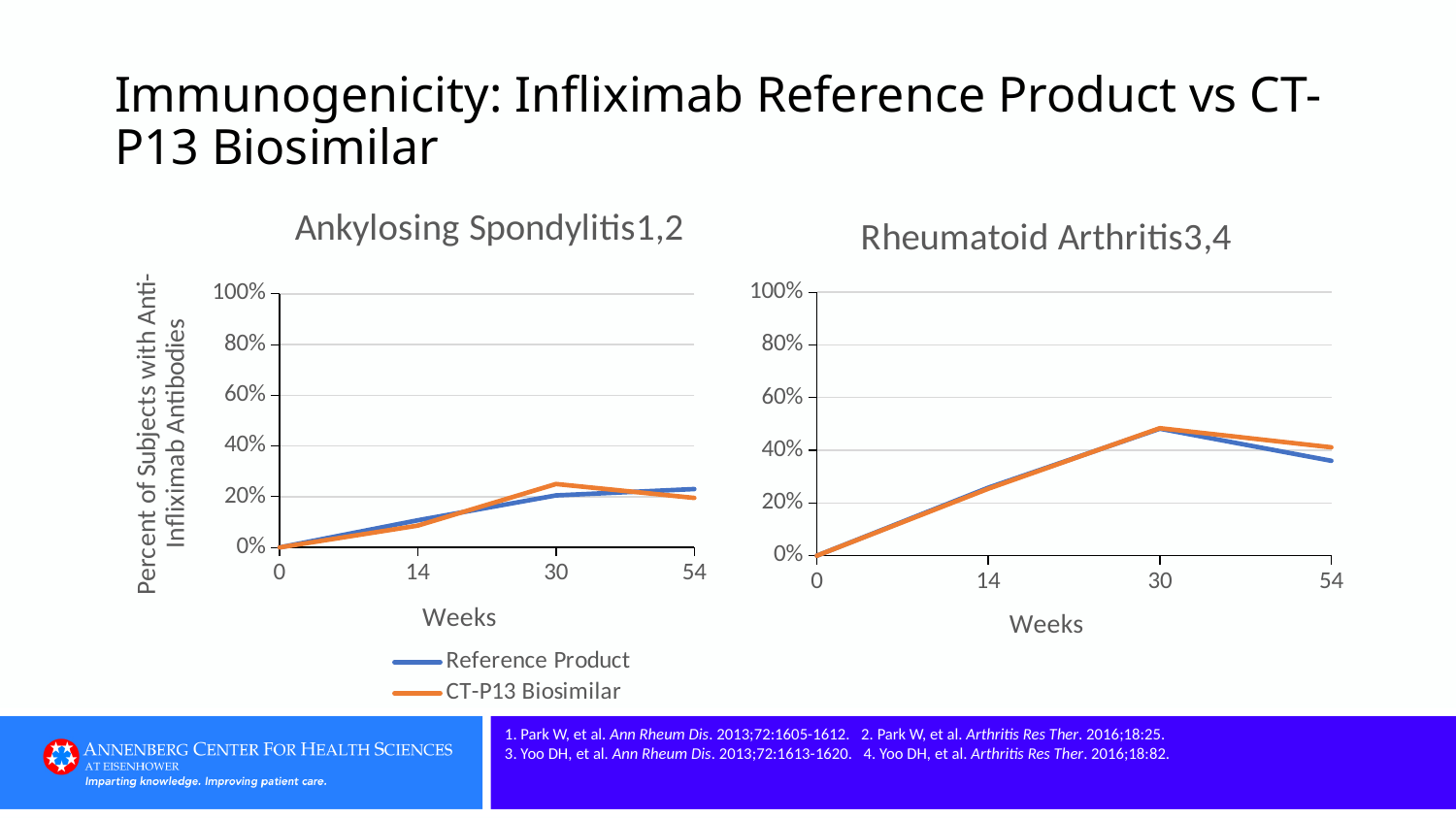
In the Rheumatoid Arthritis chart, does the Reference Product line rise or fall between week 30 and week 54? fall In the Rheumatoid Arthritis chart, at week 54, which series has the higher value: Reference Product or CT-P13 Biosimilar? CT-P13 Biosimilar In the Rheumatoid Arthritis chart, is the value for the Reference Product at week 14 greater or less than 40%? less What is the y-axis label of the Ankylosing Spondylitis chart? Percent of Subjects with Anti-Infliximab Antibodies In the Rheumatoid Arthritis chart, how many week points are marked on the x axis? 4 In the Ankylosing Spondylitis chart, is the value for the Reference Product at week 54 greater or less than 40%? less How many series does the legend list? 2 In the Rheumatoid Arthritis chart, at which week does the Reference Product reach its highest value? 30 In the Ankylosing Spondylitis chart, what is the value for the Reference Product at week 0? 0% In the Rheumatoid Arthritis chart, is the value for CT-P13 Biosimilar at week 30 greater or less than 40%? greater What kind of chart is the Ankylosing Spondylitis chart? line chart In the Ankylosing Spondylitis chart, at week 30, which series has the higher value: Reference Product or CT-P13 Biosimilar? CT-P13 Biosimilar